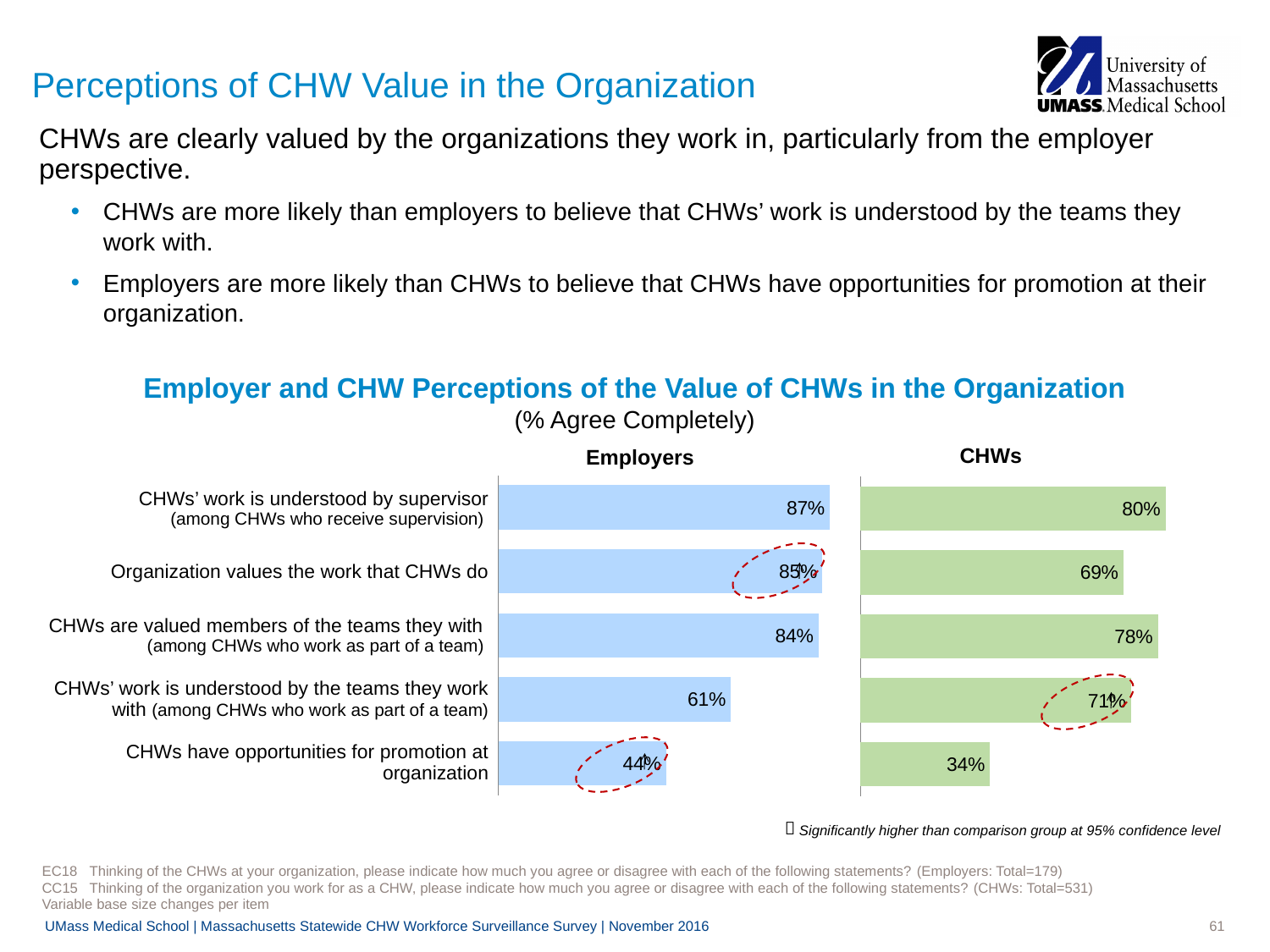
What type of chart is used to show the Employers and CHWs perceptions? Bar chart For 'CHWs' work is understood by the teams they work with', which group has the higher percentage, Employers or CHWs? CHWs In the Employers chart, what percentage agree completely that CHWs' work is understood by supervisor? 87% What is the difference between the Employers and CHWs percentages for 'CHWs have opportunities for promotion at organization'? 10% In the CHWs chart, what percentage agree completely that CHWs have opportunities for promotion at organization? 34% How many statements are shown in the Employers chart? 5 In the CHWs chart, which statement has the highest percentage? CHWs' work is understood by supervisor What is the title of the chart on the slide? Employer and CHW Perceptions of the Value of CHWs in the Organization In the CHWs chart, what percentage agree completely that the organization values the work that CHWs do? 69% What is the difference between the Employers and CHWs percentages for 'Organization values the work that CHWs do'? 16% In the Employers chart, what percentage agree completely that CHWs' work is understood by the teams they work with? 61% In the Employers chart, which statement has the lowest percentage? CHWs have opportunities for promotion at organization